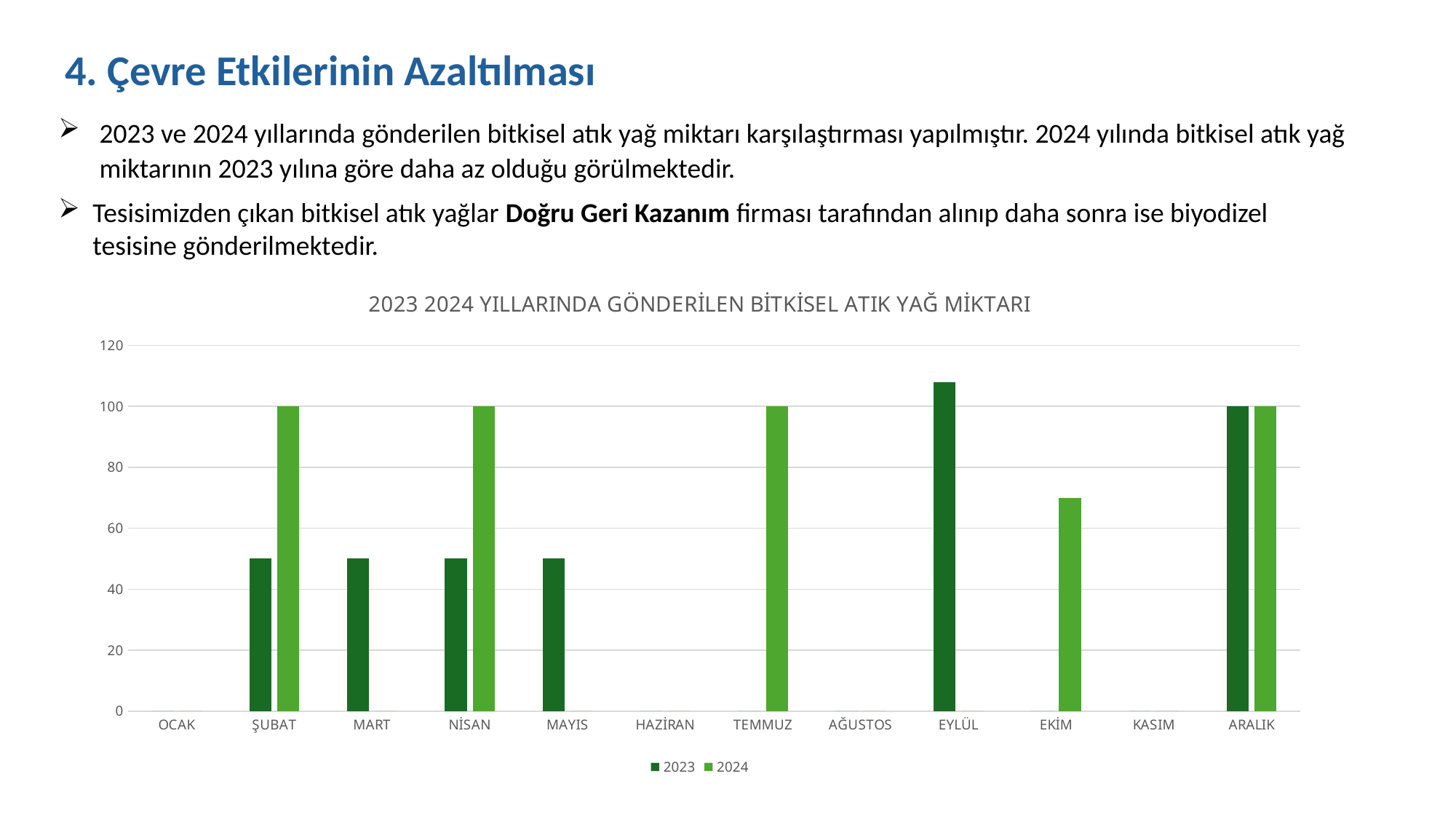
Which is larger in NİSAN, the 2023 value or the 2024 value? 2024 Is the value for 2023 in MAYIS greater or less than 60? less What is the value for 2024 in TEMMUZ? 100 How many month categories are shown on the x axis? 12 Is the value for 2023 in EYLÜL greater or less than 100? greater Which month has the highest 2023 value? EYLÜL What is the value for 2023 in ARALIK? 100 Is the value for 2024 in EKİM greater or less than 80? less How many series does the legend list? 2 What is the value for 2024 in ŞUBAT? 100 What kind of chart is shown on the slide? bar chart What is the title of the chart? 2023 2024 YILLARINDA GÖNDERİLEN BİTKİSEL ATIK YAĞ MİKTARI